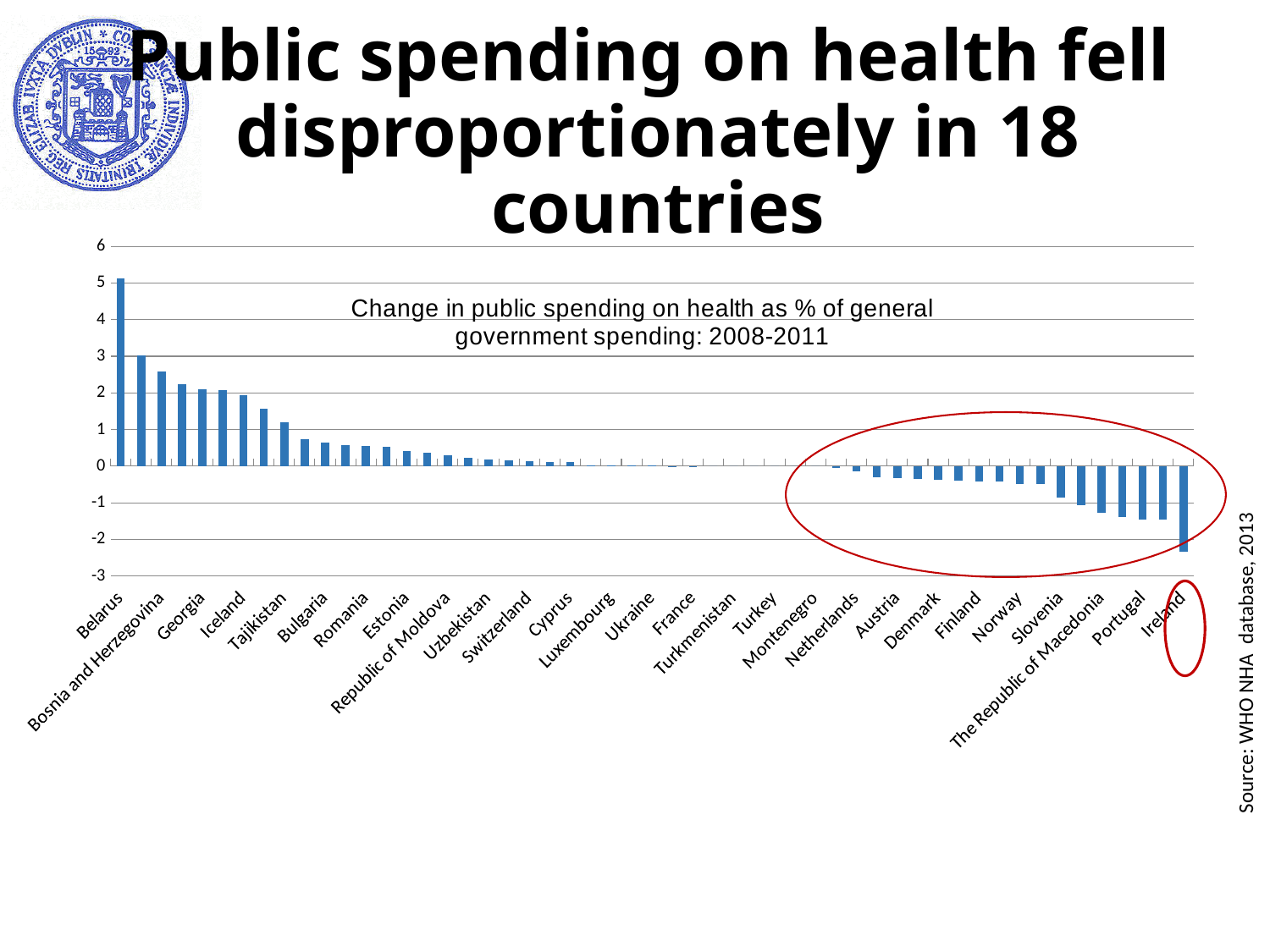
Which has the larger value, Georgia or Bulgaria? Georgia Is the value for Belarus greater or less than 4? greater What is the source cited for the chart data? WHO NHA database, 2013 What kind of chart is shown on the slide? bar chart Do the values rise or fall moving from left to right along the x axis? fall Which has the larger value, Netherlands or Portugal? Netherlands Which country has the lowest value in the chart? Ireland Is the value for Bulgaria greater or less than 1? less Is the value for Ireland greater or less than -2? less Which country has the highest value in the chart? Belarus